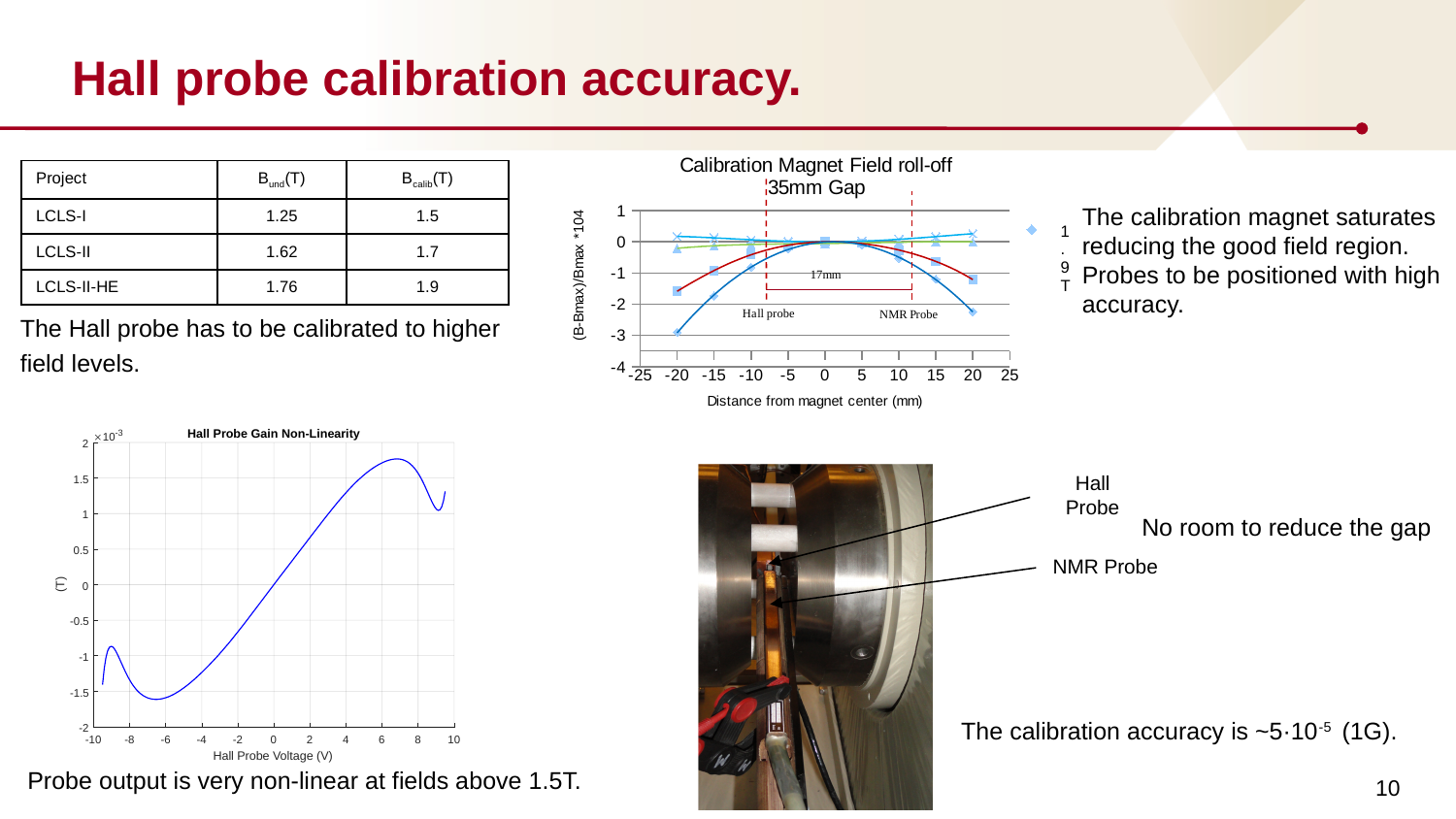
What kind of chart is the 'Hall Probe Gain Non-Linearity' chart? line chart In the 'Calibration Magnet Field roll-off 35mm Gap' chart, is the value of the lowest (blue) curve at -20 mm greater or less than -2? less In the 'Hall Probe Gain Non-Linearity' chart, what is the x-axis label? Hall Probe Voltage (V) In the 'Calibration Magnet Field roll-off 35mm Gap' chart, is the value of the red curve at -20 mm greater or less than -1? less What kind of chart is the 'Calibration Magnet Field roll-off 35mm Gap' chart? line chart In the 'Calibration Magnet Field roll-off 35mm Gap' chart, what is the x-axis label? Distance from magnet center (mm) In the 'Calibration Magnet Field roll-off 35mm Gap' chart, does the blue curve rise or fall as the distance goes from -20 mm to 0 mm? rise In the 'Hall Probe Gain Non-Linearity' chart, is the value at a Hall Probe Voltage of -6 V greater or less than -1? less In the 'Hall Probe Gain Non-Linearity' chart, does the curve rise or fall between -6 V and 6 V? rise In the 'Calibration Magnet Field roll-off 35mm Gap' chart, what is the lowest value shown on the y axis? -4